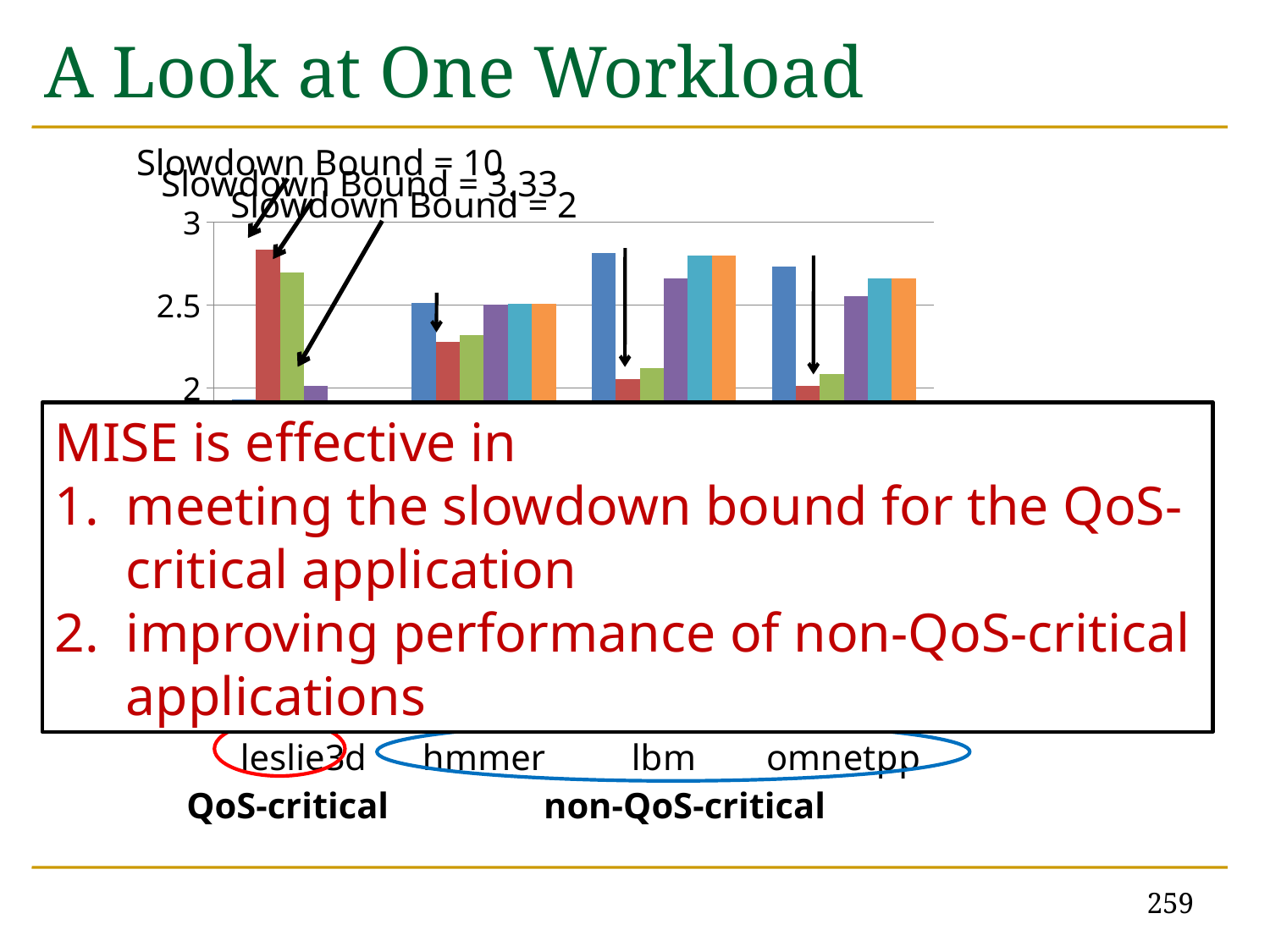
What kind of chart is shown on the slide? bar chart Is the value of the blue bar for lbm greater or less than 2.5? greater Is the value of the green bar for omnetpp greater or less than 2.5? less For lbm, which is taller: the blue bar or the red bar? the blue bar Which categories on the x axis are grouped as non-QoS-critical? hmmer, lbm, omnetpp Which category on the x axis is labeled as QoS-critical? leslie3d For leslie3d, which is taller: the red bar or the purple bar? the red bar How many categories are shown along the x axis of the chart? 4 Is the value of the orange bar for lbm greater or less than 2.5? greater For omnetpp, which is taller: the cyan bar or the green bar? the cyan bar